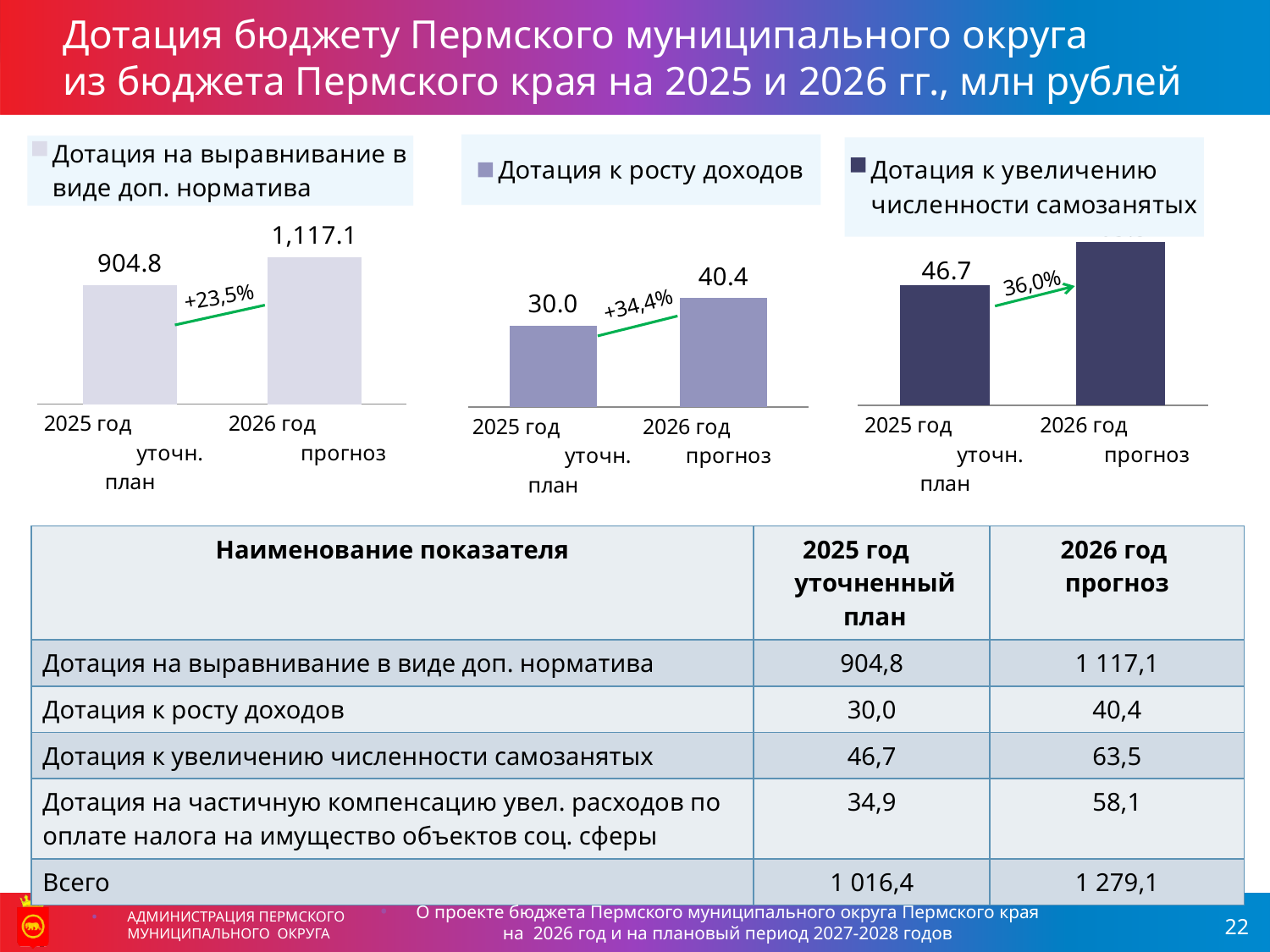
In the middle chart (Дотация к росту доходов), what is the value for 2025 год уточн. план? 30.0 In the right chart (Дотация к увеличению численности самозанятых), what is the value for 2025 год уточн. план? 46.7 In the left chart (Дотация на выравнивание в виде доп. норматива), what percentage change is shown between 2025 and 2026? +23,5% In the left chart (Дотация на выравнивание в виде доп. нормативa), what is the value for 2025 год уточн. план? 904.8 How many bars does the left chart (Дотация на выравнивание в виде доп. норматива) have? 2 What type of chart is the middle chart (Дотация к росту доходов)? Bar chart In the middle chart (Дотация к росту доходов), what is the difference between the 2026 and 2025 values? 10.4 In the left chart (Дотация на выравнивание в виде доп. норматива), what is the value for 2026 год прогноз? 1,117.1 In the middle chart (Дотация к росту доходов), what is the value for 2026 год прогноз? 40.4 In the right chart (Дотация к увеличению численности самозанятых), which year has the taller bar, 2025 or 2026? 2026 год In the left chart (Дотация на выравнивание в виде доп. норматива), do the values rise or fall from 2025 to 2026? Rise In the right chart (Дотация к увеличению численности самозанятых), what percentage change is shown between 2025 and 2026? 36,0%